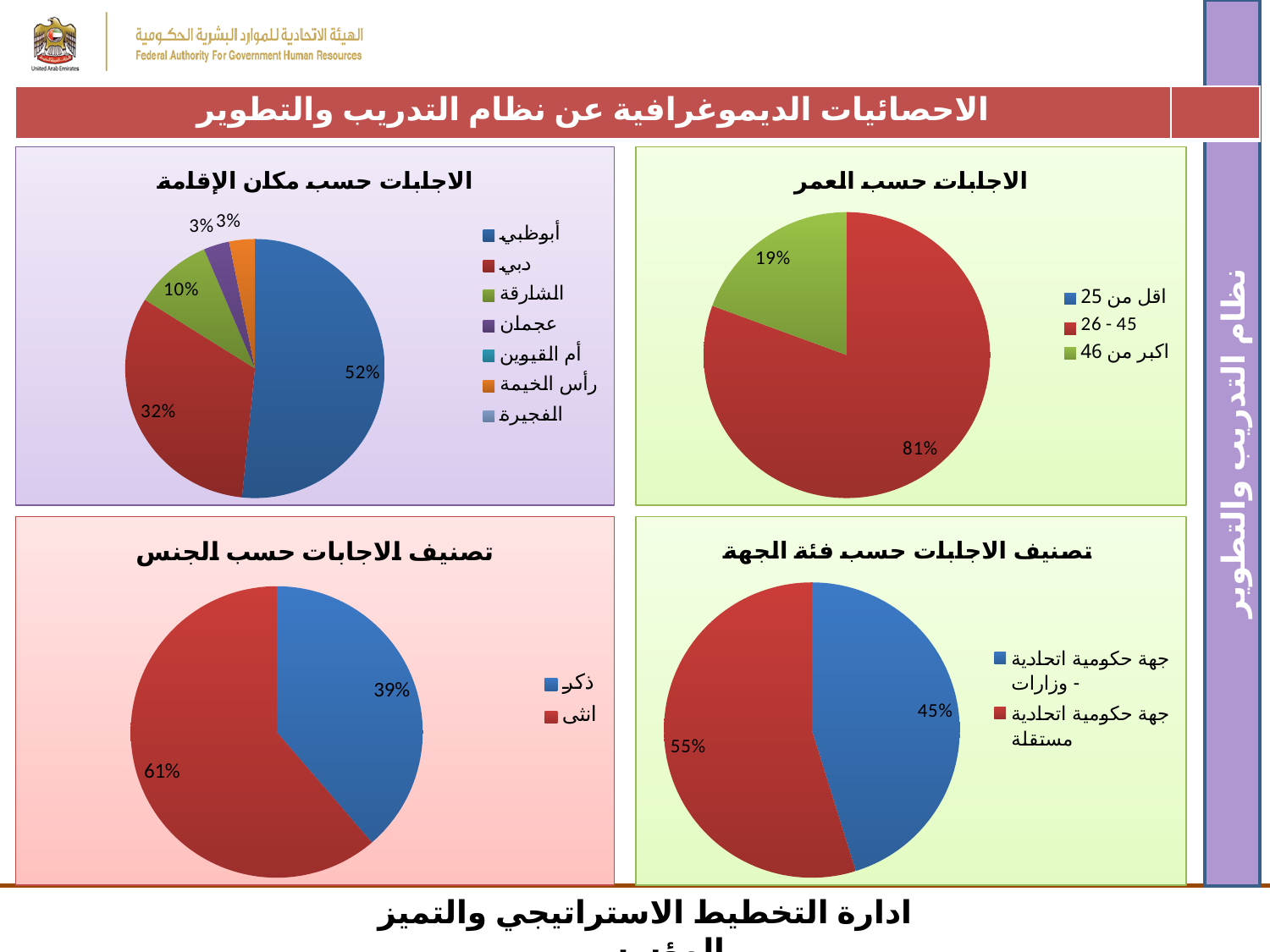
In the top-left pie chart (الاجابات حسب مكان الإقامة), what percentage is shown for الشارقة? 10% In the bottom-left pie chart (تصنيف الاجابات حسب الجنس), what percentage is shown for انثى? 61% In the top-right pie chart (الاجابات حسب العمر), what percentage is shown for اكبر من 46? 19% What type of chart is used in the bottom-right chart (تصنيف الاجابات حسب فئة الجهة)? Pie chart In the top-left pie chart (الاجابات حسب مكان الإقامة), which category has the largest share? أبوظبي In the bottom-right pie chart (تصنيف الاجابات حسب فئة الجهة), what percentage is shown for جهة حكومية اتحادية مستقلة? 55% In the top-right pie chart (الاجابات حسب العمر), what percentage is shown for the 26 - 45 age group? 81% In the top-left pie chart (الاجابات حسب مكان الإقامة), what percentage is shown for دبي? 32% In the bottom-left pie chart (تصنيف الاجابات حسب الجنس), which is larger, the share for ذكر or the share for انثى? انثى In the top-left pie chart (الاجابات حسب مكان الإقامة), what is the difference between the shares for أبوظبي and دبي? 20% In the top-left pie chart (الاجابات حسب مكان الإقامة), what percentage is shown for أبوظبي? 52% In the top-left pie chart (الاجابات حسب مكان الإقامة), how many entries does the legend list? 7